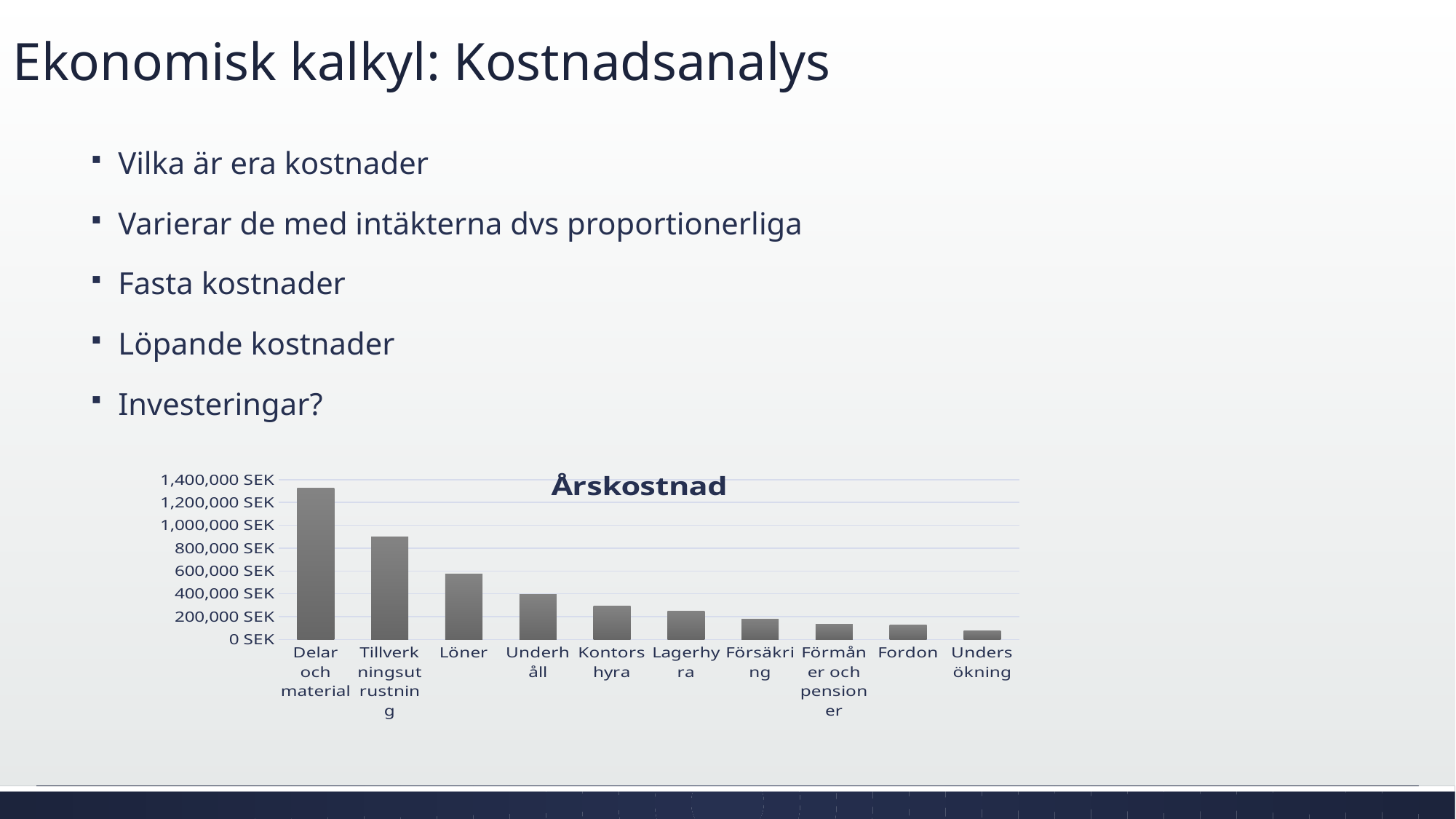
Is the value for Kontorshyra greater or less than 400,000 SEK? less What kind of chart is shown on the slide? bar chart Which category has the lowest annual cost? Undersökning What is the title of the chart? Årskostnad Which is larger, the value for Löner or the value for Underhåll? Löner Is the value for Tillverkningsutrustning greater or less than 1,000,000 SEK? less Is the value for Undersökning greater or less than 200,000 SEK? less Which category has the highest annual cost? Delar och material How many categories are shown in the chart? 10 Do the values rise or fall from left to right along the x axis? fall